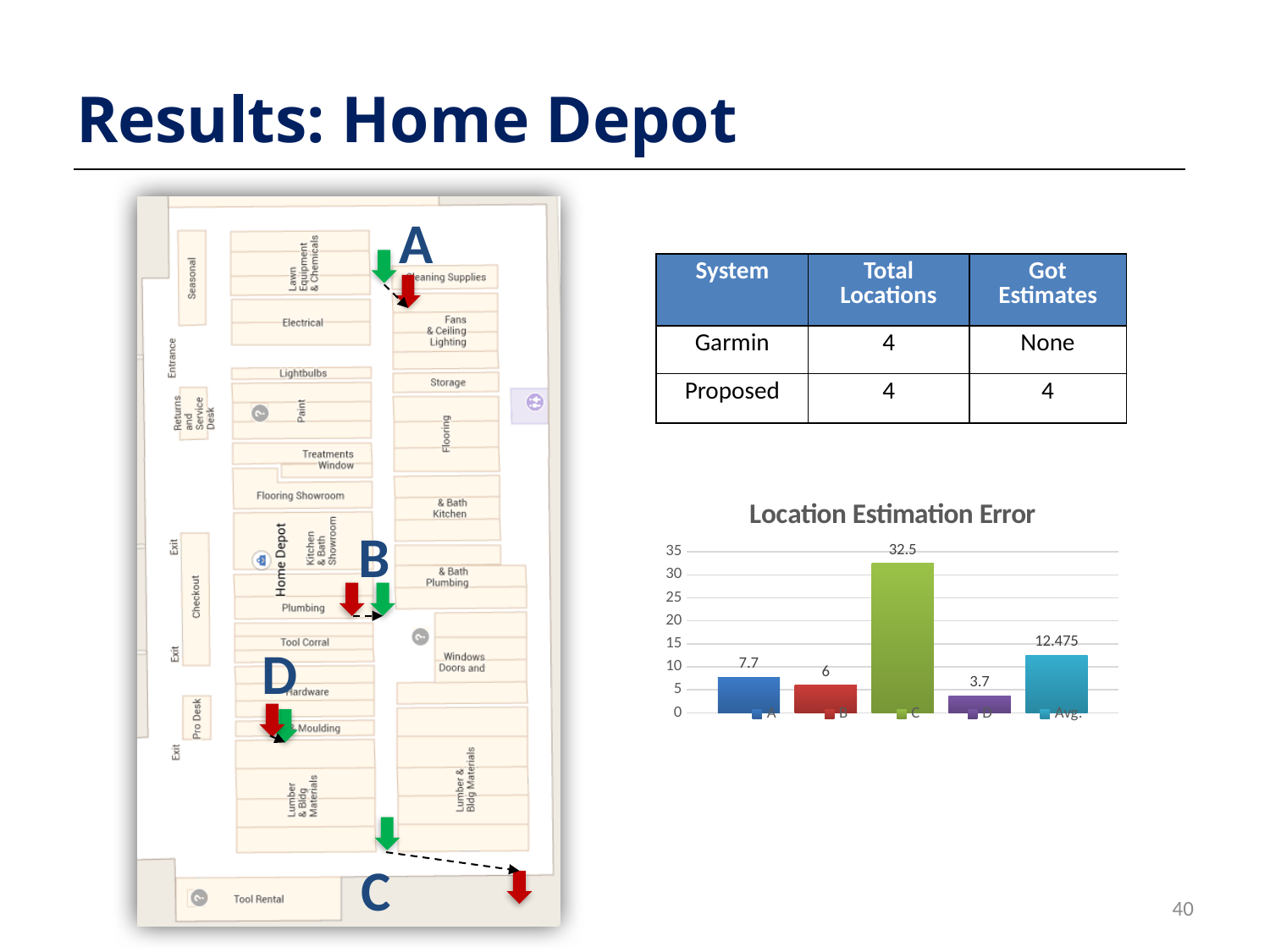
Which category has the lowest value in the Location Estimation Error chart? D What is the value for D in the Location Estimation Error chart? 3.7 What is the value for C in the Location Estimation Error chart? 32.5 Is the value for C in the Location Estimation Error chart greater or less than 30? greater What kind of chart is the Location Estimation Error chart? Bar chart In the Location Estimation Error chart, which is larger, the value for B or the value for D? B What is the difference between the values for A and B in the Location Estimation Error chart? 1.7 How many bars are shown in the Location Estimation Error chart? 5 What is the value for A in the Location Estimation Error chart? 7.7 What is the value for Avg. in the Location Estimation Error chart? 12.475 Which category has the highest value in the Location Estimation Error chart? C What is the difference between the values for C and Avg. in the Location Estimation Error chart? 20.025